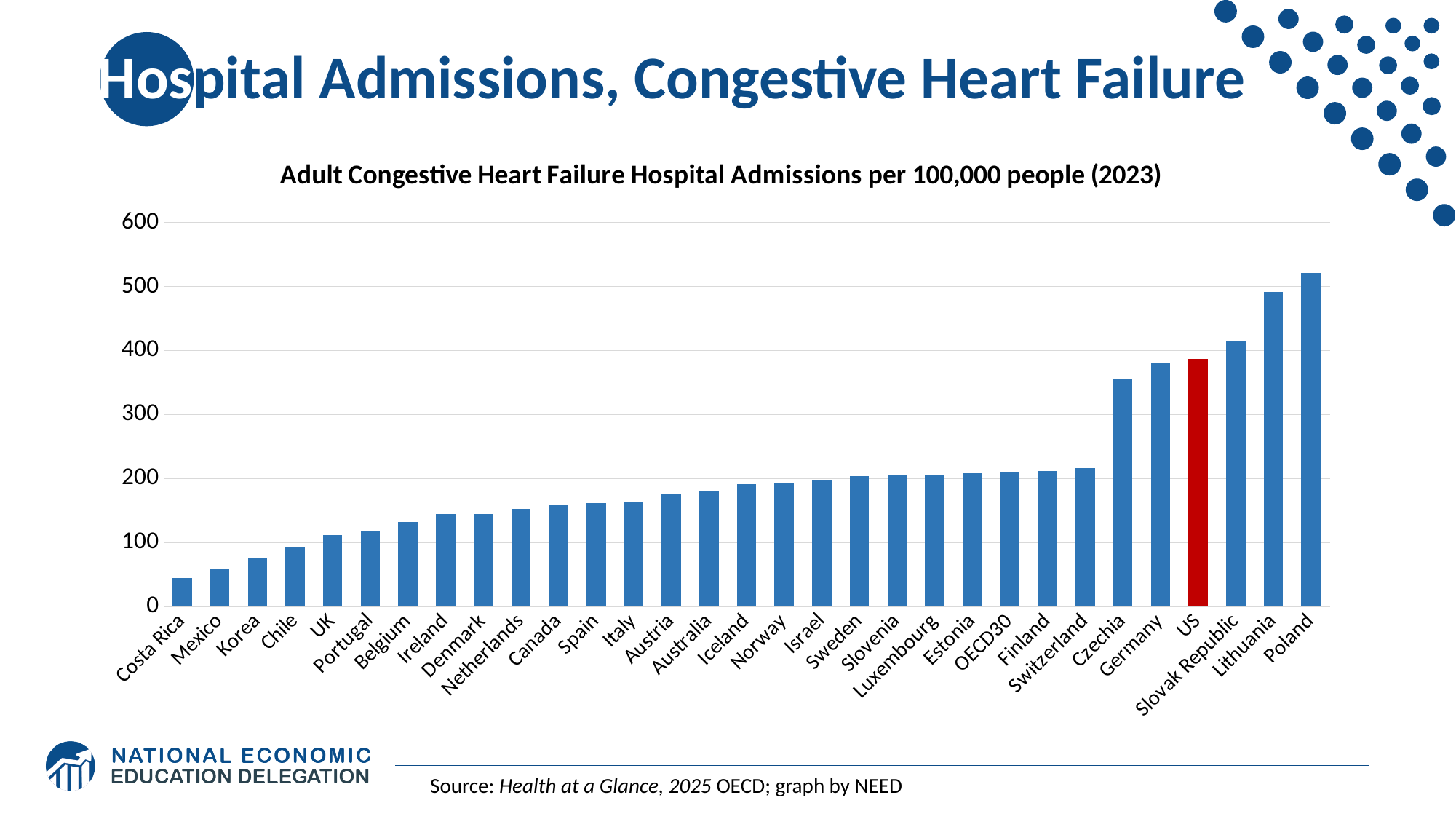
Is the value for Switzerland greater or less than 200? greater Is the value for Costa Rica greater or less than 100? less Do the values rise or fall moving from left to right along the x axis? rise How many bars (countries and groups) are plotted in the chart? 31 Which country has the highest rate of adult congestive heart failure hospital admissions per 100,000 people? Poland What kind of chart is shown on the slide? bar chart Is the value for Poland greater or less than 500? greater Which has a higher value, the US or the Slovak Republic? Slovak Republic Which country has the lowest rate of adult congestive heart failure hospital admissions per 100,000 people? Costa Rica Which bar is coloured red instead of blue? US